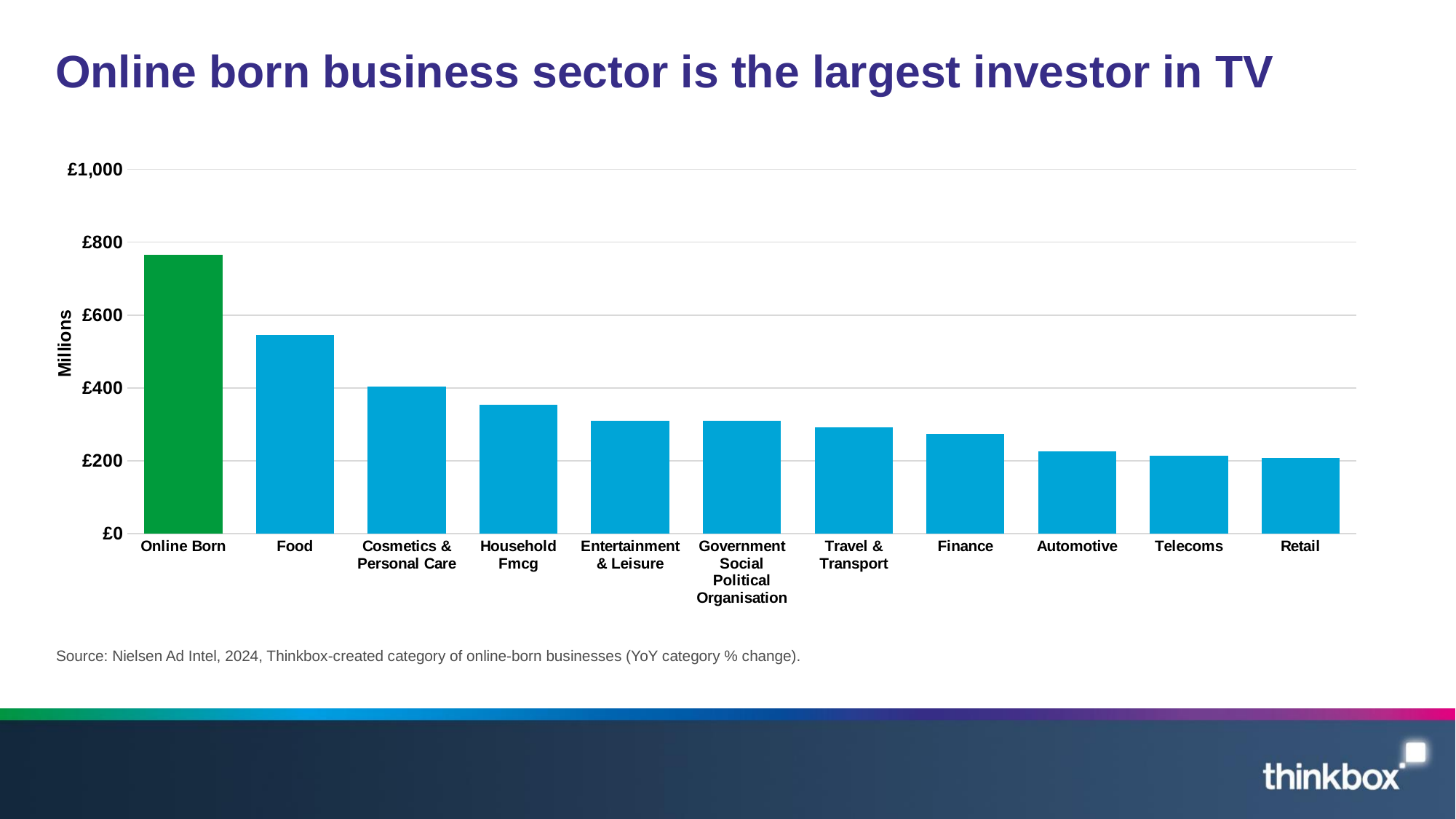
Is the value for Food greater or less than £400? greater Is the value for Online Born greater or less than £600? greater Which sector has the highest TV investment in the chart? Online Born Do the bar values rise or fall moving from left to right along the x axis? fall Is the value for Food greater or less than £600? less What colour is the Online Born bar? green How many sectors are shown on the x axis of the chart? 11 Which is larger, the value for Food or the value for Cosmetics & Personal Care? Food What kind of chart is shown on the slide? bar chart Which is larger, the value for Online Born or the value for Food? Online Born